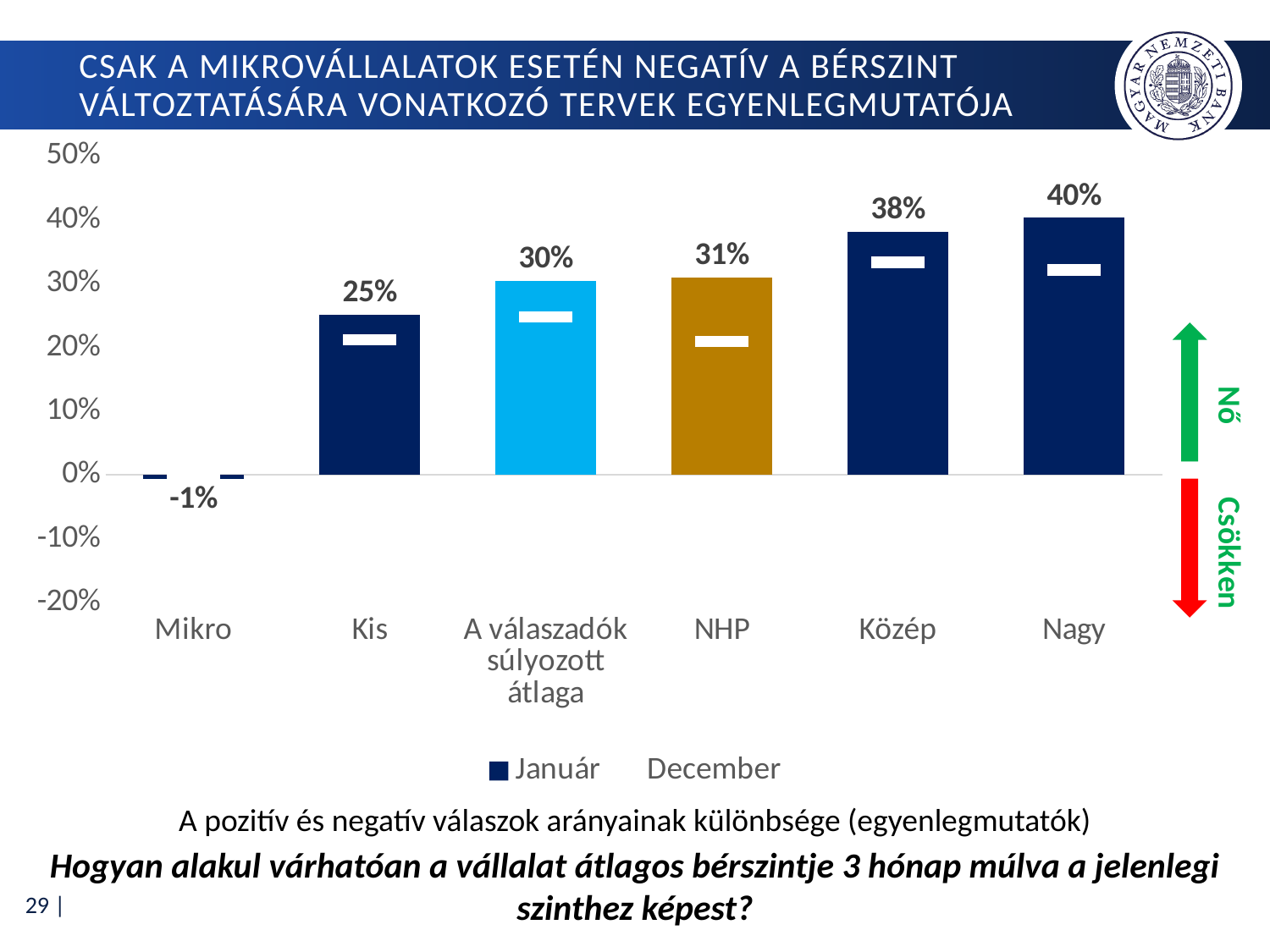
How many categories are shown on the x axis? 6 Which has a larger Január value, Közép or NHP? Közép What is the difference between the Január values for Nagy and Kis? 15% How many series does the legend list? 2 Which category has the lowest Január value? Mikro What kind of chart is shown on the slide? bar chart Which category has the highest Január value? Nagy What is the Január value for Nagy? 40% What is the Január value for Mikro? -1% What is the Január value for A válaszadók súlyozott átlaga? 30% Is the Január value for Kis greater or less than 20%? greater What is the Január value for NHP? 31%